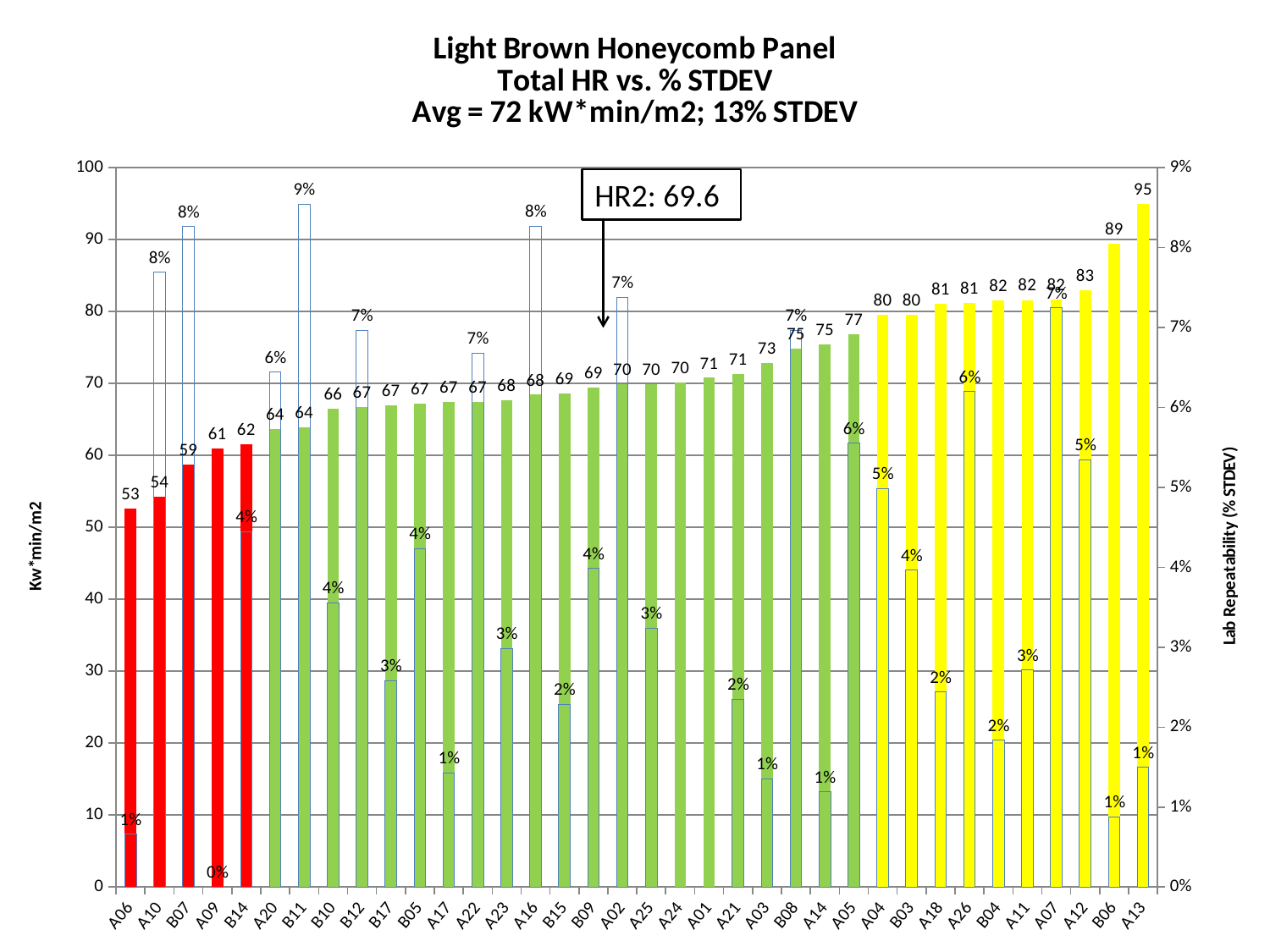
How many samples are shown on the x axis? 36 What is the total HR value for A05? 77 What is the lab repeatability (% STDEV) value for A09? 0% Which sample has the lowest total HR value? A06 What is the total HR value for A13? 95 Which sample has the highest total HR value? A13 What is the difference between the total HR values of A13 and A06? 42 Which has a higher total HR value, B06 or A12? B06 What is the lab repeatability (% STDEV) value for B11? 9% Which sample has the highest lab repeatability (% STDEV) value? B11 What value does the HR2 annotation box show? 69.6 What kind of chart is shown on the slide? Bar chart